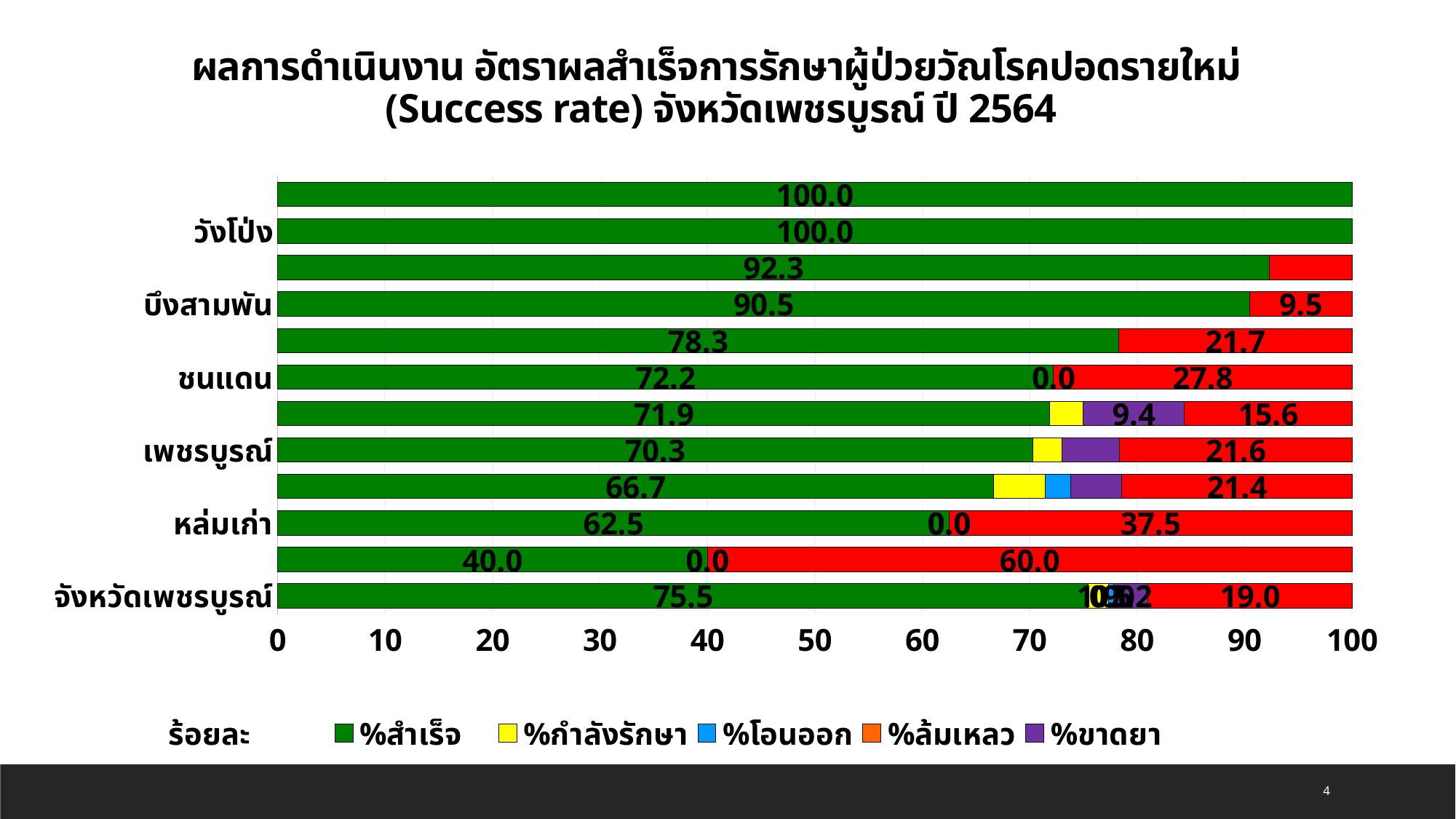
How many series does the legend list? 5 Which has the higher %สำเร็จ value, บึงสามพัน or ชนแดน? บึงสามพัน What is the %สำเร็จ value for บึงสามพัน? 90.5 What is the %สำเร็จ value for หล่มเก่า? 62.5 What kind of chart is shown on the slide? bar chart What is the %สำเร็จ value for จังหวัดเพชรบูรณ์? 75.5 How many bars are plotted in the chart? 12 What is the difference between the %สำเร็จ values of บึงสามพัน and หล่มเก่า? 28.0 What is the %สำเร็จ value for ชนแดน? 72.2